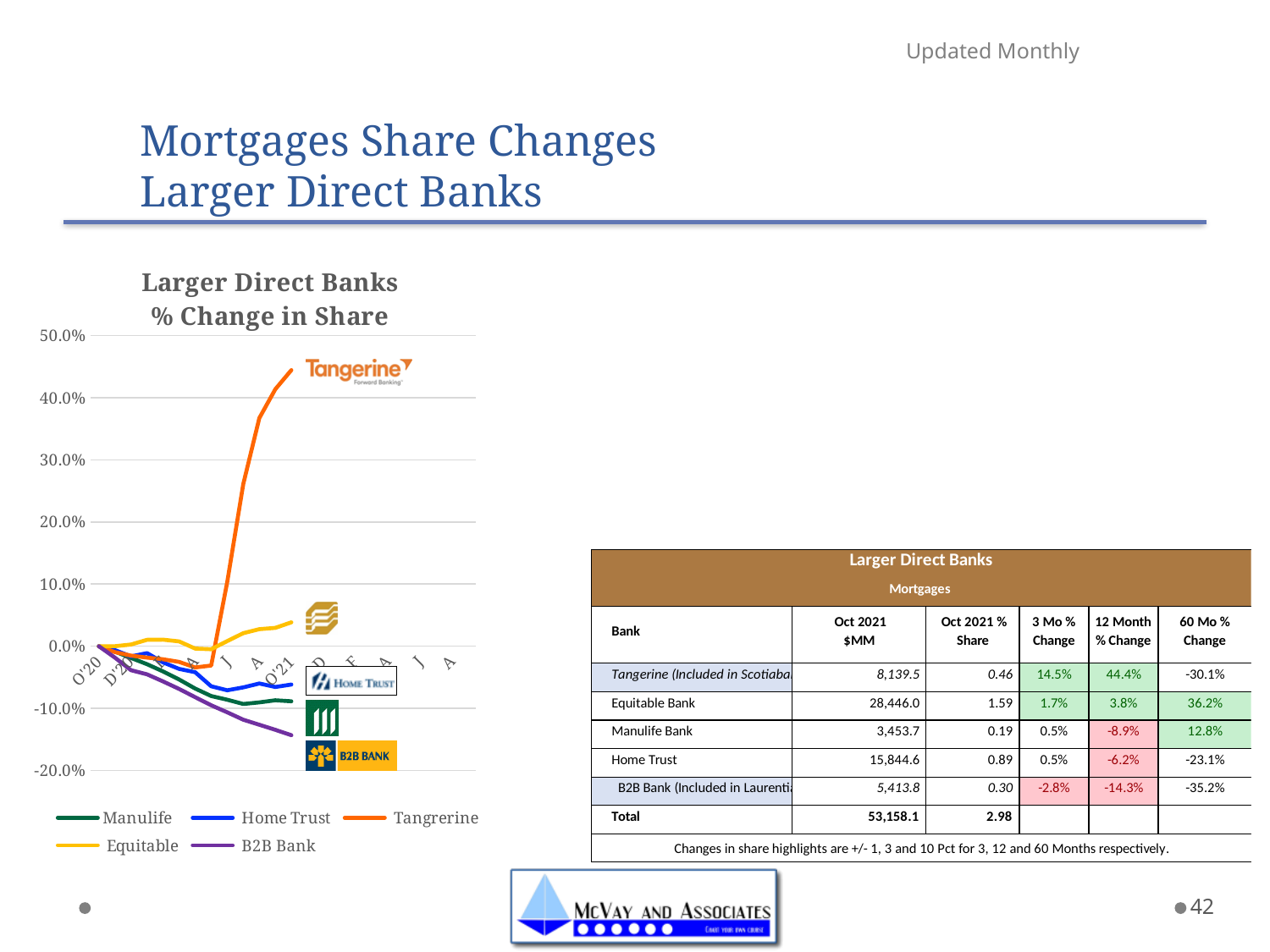
Is the final value for Manulife greater or less than 0.0%? less Does the Tangerine line rise or fall over the last few months shown? rise What is the title of the chart? Larger Direct Banks % Change in Share What kind of chart is shown on the slide? line chart At the right end of the chart, which is larger: Tangerine or Equitable? Tangerine Which series has the highest value at the right end of the chart? Tangerine Which series has the lowest value at the right end of the chart? B2B Bank Is the final value for B2B Bank greater or less than -10.0%? less Is the final value for Tangerine greater or less than 40.0%? greater How many series does the chart legend list? 5 Does the B2B Bank line rise or fall along the x axis? fall